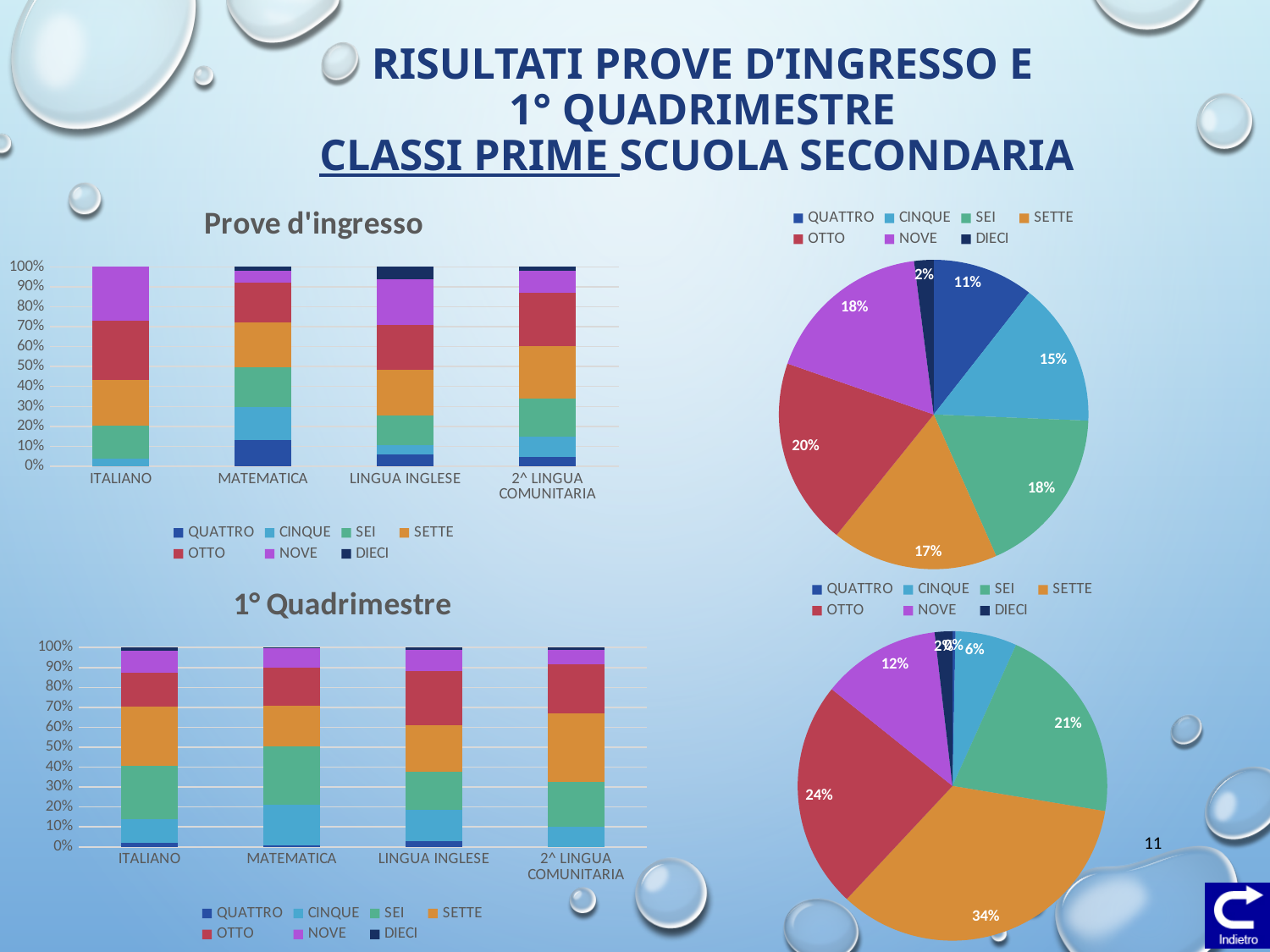
How many categories are shown on the x axis of the '1° Quadrimestre' chart? 4 In the bottom-right pie chart, which is larger, the SEI slice or the CINQUE slice? SEI How many series does the legend of the 'Prove d'ingresso' chart list? 7 In the top-right pie chart, what percentage is shown for the CINQUE slice? 15% What kind of chart is the 'Prove d'ingresso' chart? Stacked bar chart In the 'Prove d'ingresso' chart, is the value for QUATTRO in MATEMATICA greater or less than 10%? greater In the top-right pie chart, which category has the smallest share? DIECI In the top-right pie chart, which category has the largest share? OTTO In the bottom-right pie chart, what is the difference between the SETTE share and the OTTO share? 10% In the top-right pie chart, what percentage is shown for the OTTO slice? 20% In the bottom-right pie chart, what percentage is shown for the NOVE slice? 12% In the bottom-right pie chart, what percentage is shown for the SETTE slice? 34%